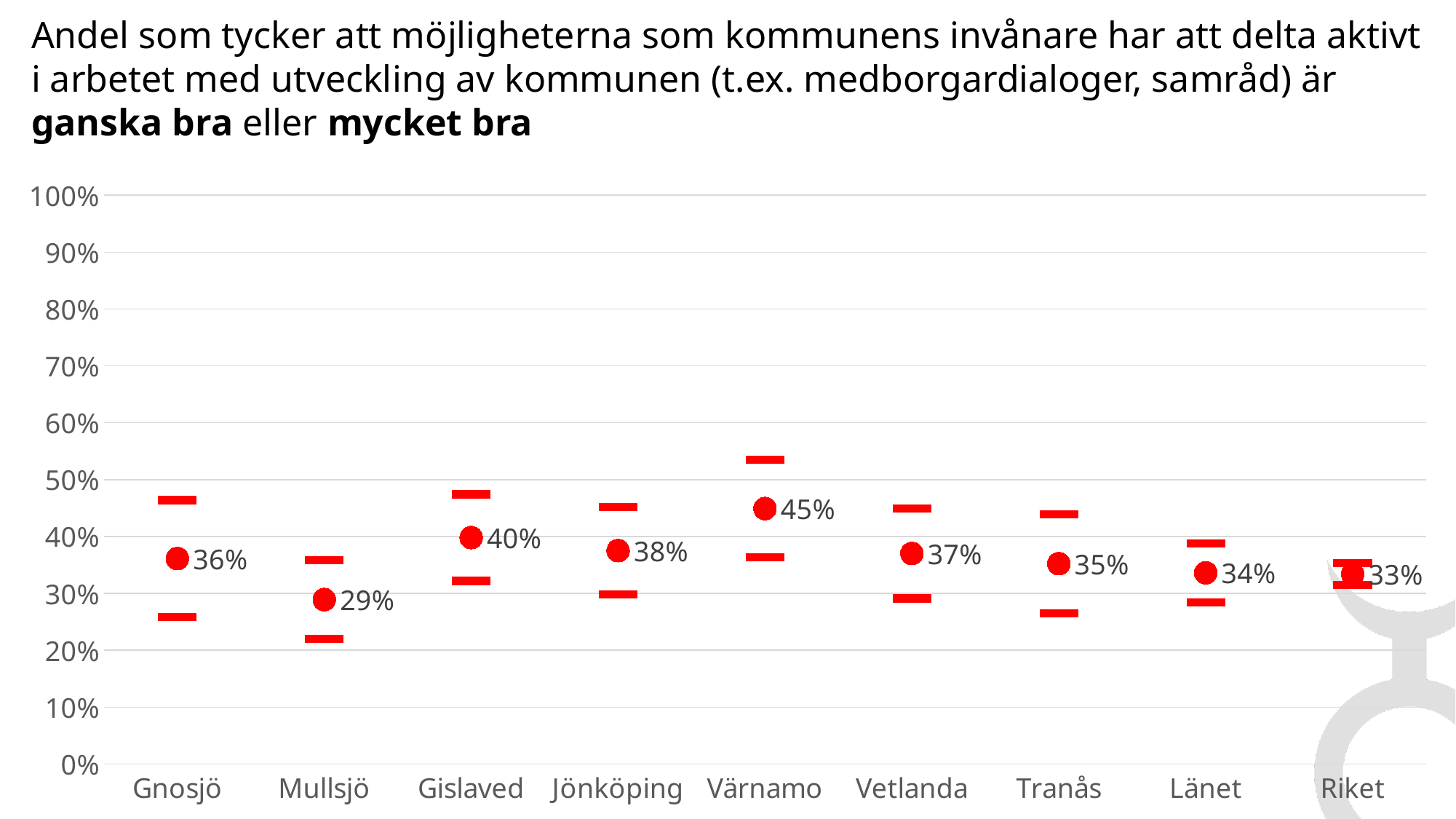
What is the value for Riket? 33% How many categories are shown on the x axis? 9 Which is larger, the value for Jönköping or the value for Tranås? Jönköping What is the difference between the values for Gislaved and Länet? 6 percentage points What is the value for Värnamo? 45% What is the difference between the values for Värnamo and Mullsjö? 16 percentage points What is the value for Gislaved? 40% What is the value for Mullsjö? 29% What kind of chart is this? Dot plot with error bars Which category has the lowest value? Mullsjö Which category has the highest value? Värnamo Is the value for Gnosjö greater or less than 50%? less